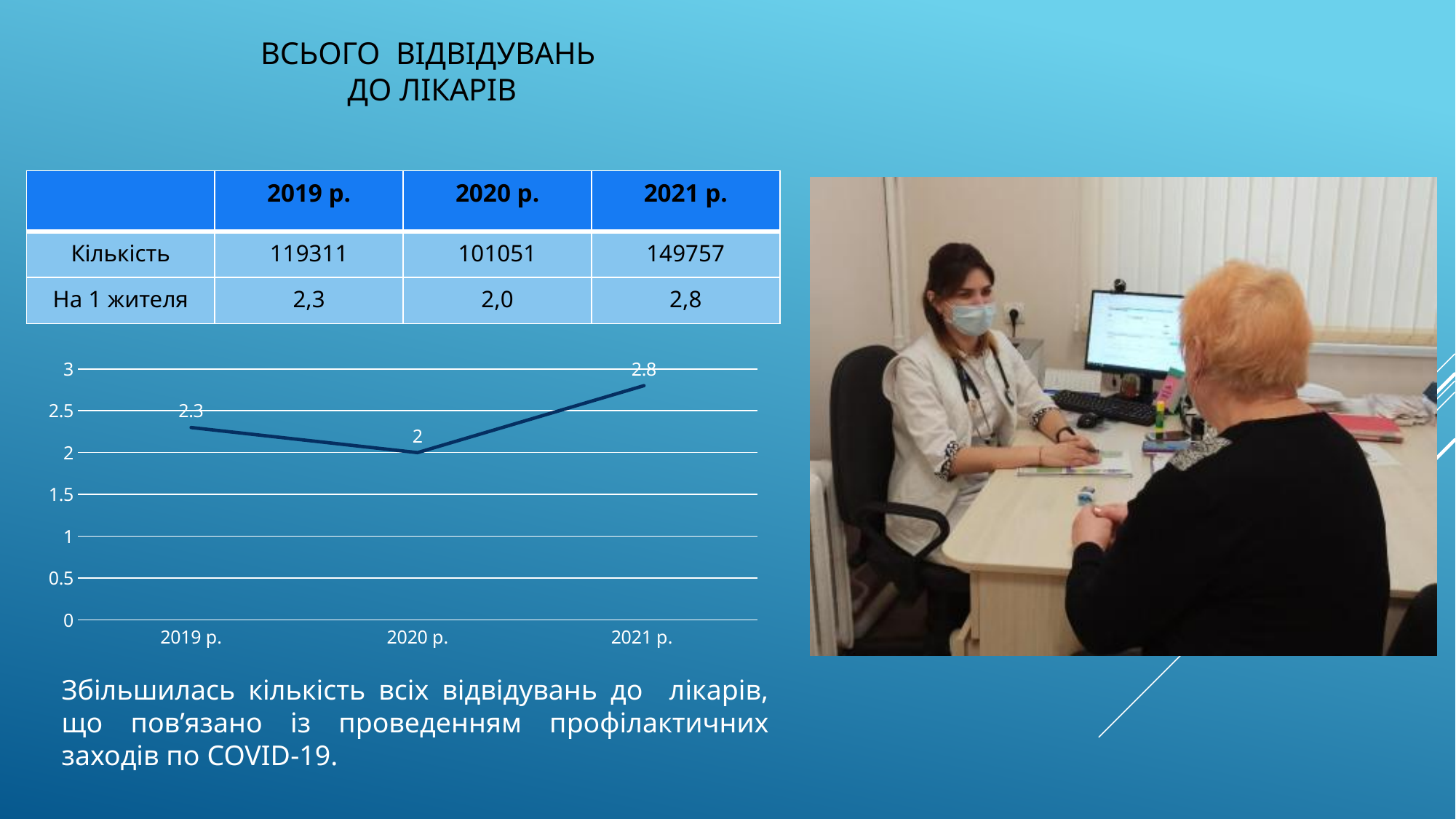
Which year has the lowest value in the line chart? 2020 р. Is the value for 2021 р. in the line chart greater or less than 2.5? greater Does the line in the chart rise or fall from 2020 р. to 2021 р.? rise How many data points are plotted in the line chart? 3 What is the value plotted for 2020 р. in the line chart? 2 What is the value plotted for 2019 р. in the line chart? 2.3 What is the difference between the values for 2019 р. and 2020 р. in the line chart? 0.3 What is the difference between the values for 2021 р. and 2020 р. in the line chart? 0.8 Which year has the highest value in the line chart? 2021 р. What type of chart is shown on the slide? line chart Which is larger in the line chart, the value for 2019 р. or the value for 2021 р.? 2021 р. What is the value plotted for 2021 р. in the line chart? 2.8